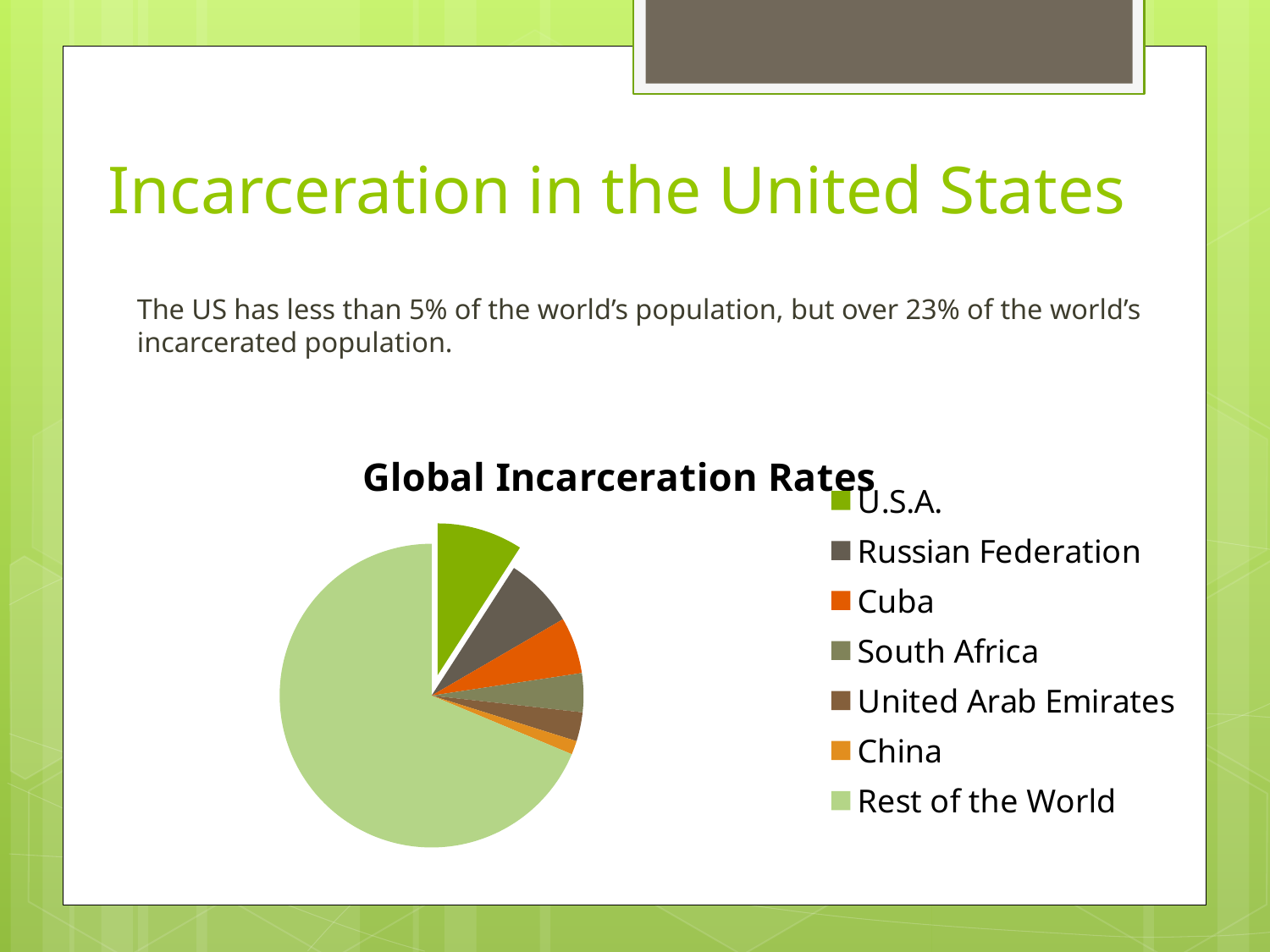
Which slice is larger, Russian Federation or China? Russian Federation Which slice is larger, U.S.A. or United Arab Emirates? U.S.A. How many slices does the pie chart have? 7 Which slice is larger, U.S.A. or Cuba? U.S.A. What kind of chart is shown on the slide? Pie chart Which category has the largest slice of the pie chart? Rest of the World What is the title of the chart? Global Incarceration Rates How many categories does the legend of the pie chart list? 7 Which slice of the pie chart is pulled out (exploded) from the rest of the pie? U.S.A. Which category is listed last in the legend of the pie chart? Rest of the World